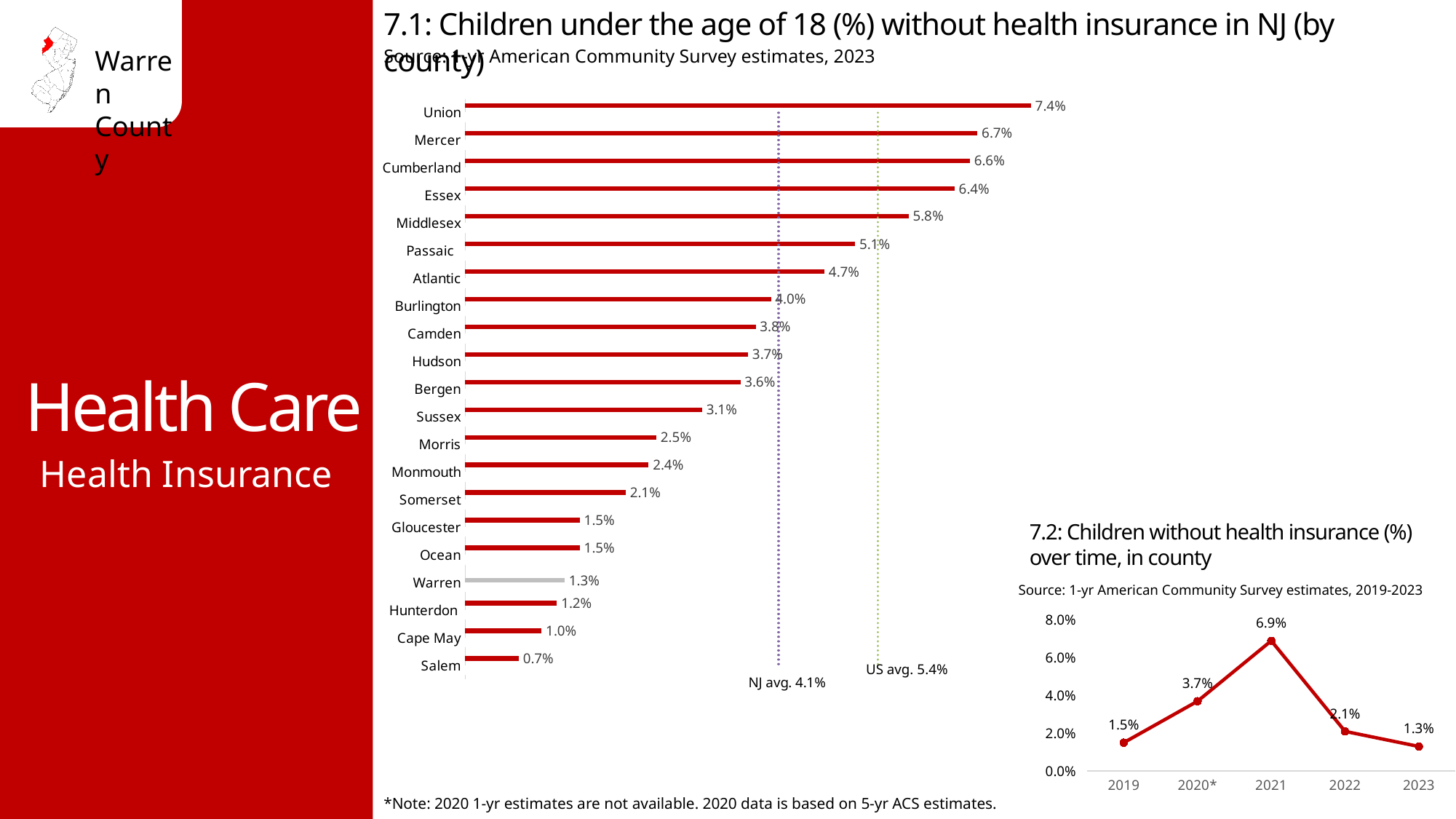
In chart 7.2, which year has the highest value? 2021 In chart 7.1, what is the difference between the values for Union and Salem? 6.7% In chart 7.1 (children under 18 without health insurance by county), what is the value for Warren? 1.3% In chart 7.1, which county has the lowest percentage of children without health insurance? Salem In chart 7.1, which county has the highest percentage of children without health insurance? Union In chart 7.2 (children without health insurance over time in county), what is the value for 2021? 6.9% In chart 7.1, which county has a larger value, Passaic or Atlantic? Passaic In chart 7.1, what is the NJ average shown by the dotted reference line? 4.1% In chart 7.2, what is the difference between the values for 2021 and 2023? 5.6% What type of chart is chart 7.1? Bar chart In chart 7.1, how many counties are shown? 21 In chart 7.1, what is the value for Middlesex? 5.8%